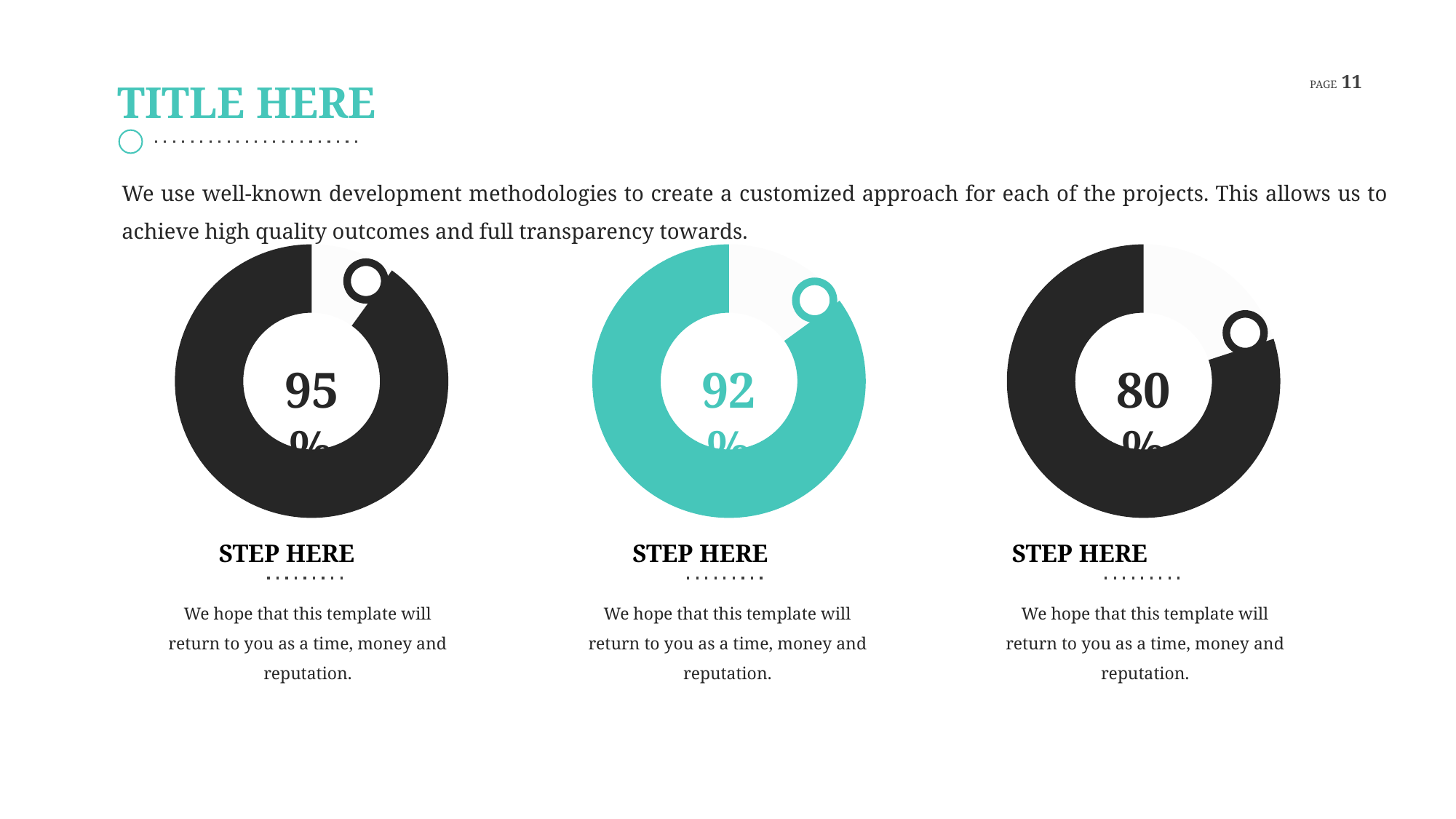
How many donut charts are on the slide? 3 Which of the three donut charts shows the lowest percentage? The right chart (80%) What value is shown in the centre of the middle donut chart? 92% Which donut chart is coloured teal rather than black? The middle chart (92%) What value is shown in the centre of the right donut chart? 80% What is the difference between the value in the left donut chart and the value in the right donut chart? 15% What is the difference between the value in the left donut chart and the value in the middle donut chart? 3% What value is shown in the centre of the left donut chart? 95% Is the value in the middle donut chart larger or smaller than the value in the right donut chart? Larger What kind of chart is used to display the percentages on this slide? Donut chart What label appears beneath each of the three donut charts? STEP HERE Which of the three donut charts shows the highest percentage? The left chart (95%)